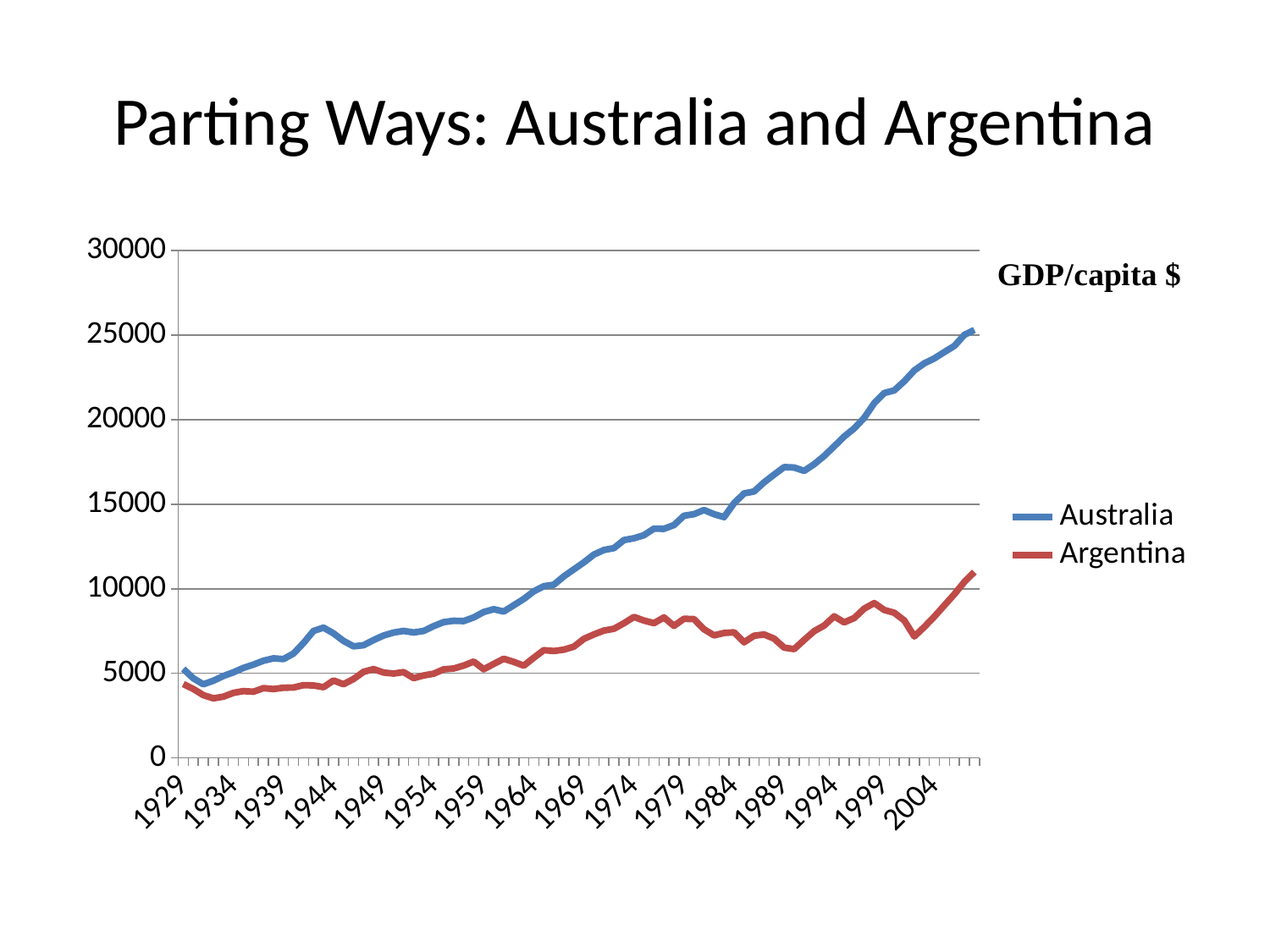
Is the value for Argentina in 1969 greater or less than 10000? less Is the value for Australia in 1989 greater or less than 15000? greater Which series has the higher value in 1984, Australia or Argentina? Australia Is the value for Argentina in 2004 greater or less than 10000? less Does the Australia line generally rise or fall from 1929 to the end of the series? rise How many series does the legend list? 2 What colour is the Australia line? blue Which series reaches the highest value on the chart? Australia Which two series are listed in the legend? Australia and Argentina What kind of chart is shown on the slide? line chart